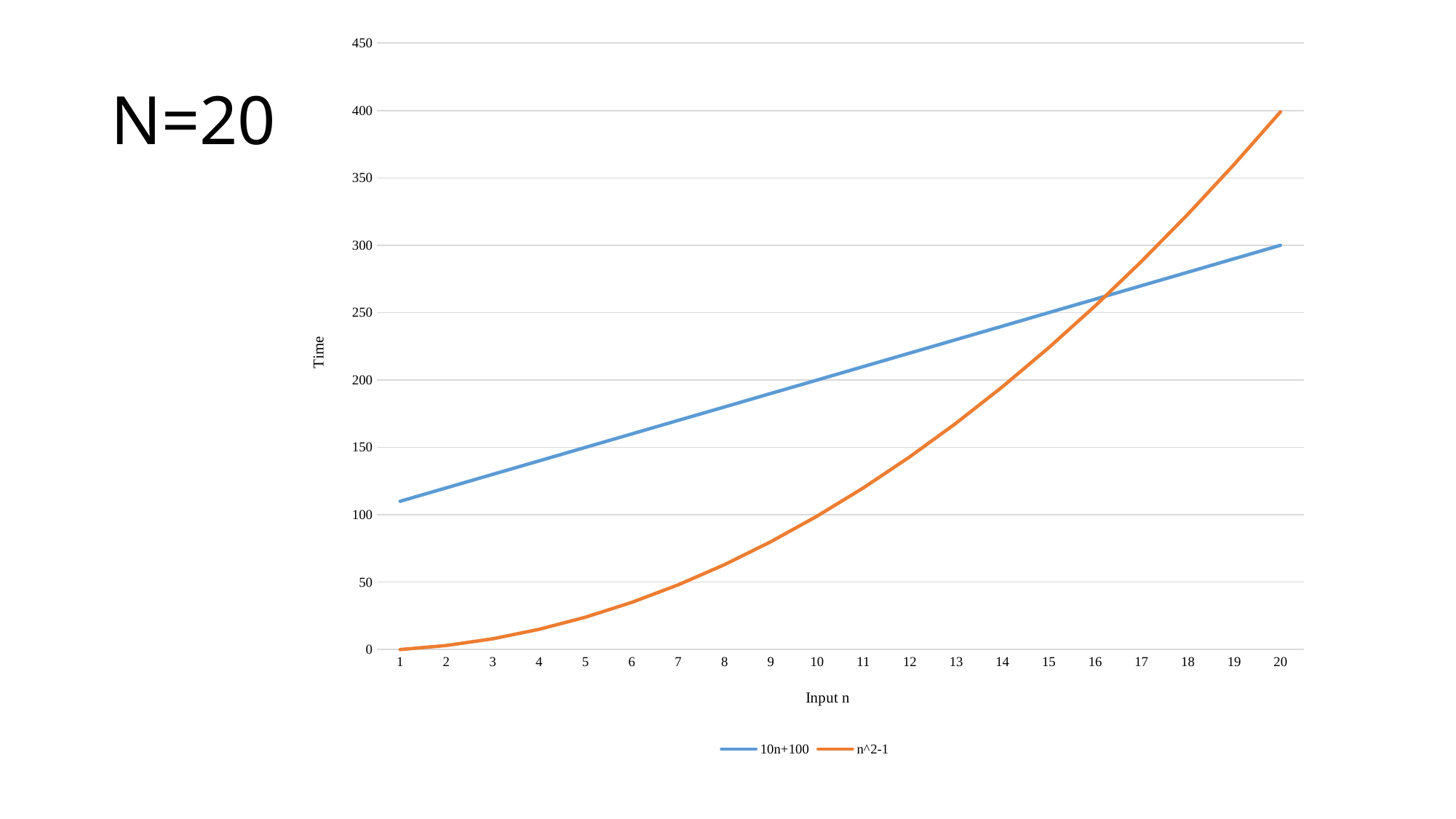
What kind of chart is shown on the slide? line chart What is the label of the vertical axis? Time How many points along the x axis (Input n) does each line cover? 20 What is the value of the 10n+100 line at Input n = 10? 200 What is the value of the 10n+100 line at Input n = 20? 300 Is the value of the n^2-1 line at Input n = 20 greater or less than 350? greater At Input n = 5, which series has the larger value, 10n+100 or n^2-1? 10n+100 How many series does the legend list? 2 At Input n = 20, which series has the larger value, 10n+100 or n^2-1? n^2-1 Is the value of the n^2-1 line at Input n = 10 greater or less than 150? less Does the n^2-1 line rise or fall as Input n increases? rise What is the value of the n^2-1 line at Input n = 1? 0